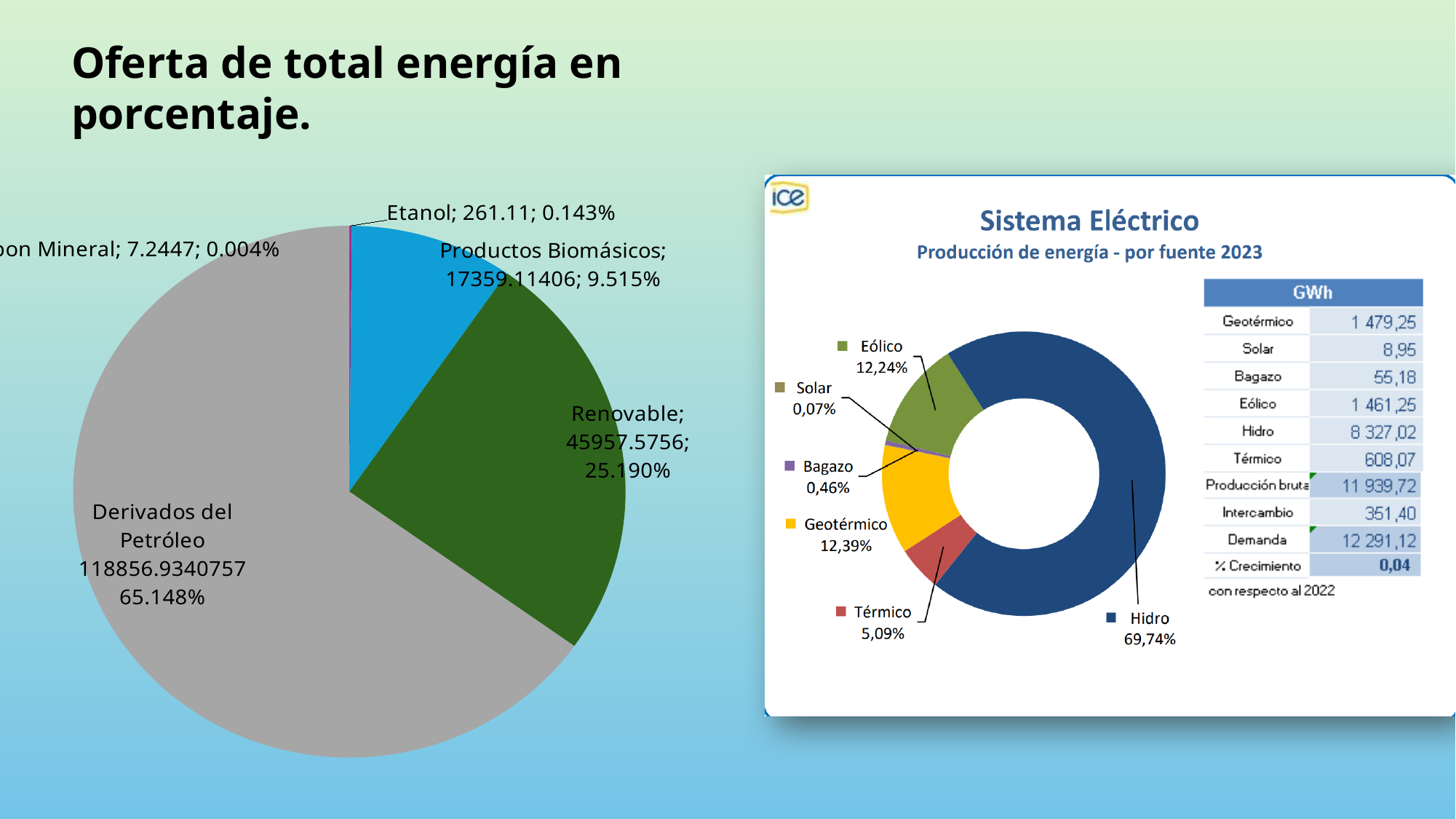
In the left pie chart, which category has the largest slice? Derivados del Petróleo How many energy sources are shown in the Sistema Eléctrico donut chart? 6 In the left pie chart, what is the difference in percentage points between Renovable (25.190%) and Productos Biomásicos (9.515%)? 15.675 In the Sistema Eléctrico table, what is the GWh value for Hidro? 8 327,02 In the left pie chart, what percentage is shown for Productos Biomásicos? 9.515% In the Sistema Eléctrico chart, what percentage is shown for Térmico? 5,09% In the left pie chart, what value is shown for Renovable? 45957.5756 In the left pie chart, which is larger, Renovable or Productos Biomásicos? Renovable In the left pie chart, what percentage share is shown for Derivados del Petróleo? 65.148% In the Sistema Eléctrico chart, which source has the smallest share? Solar In the Sistema Eléctrico chart, what percentage share does Hidro have? 69,74% What kind of chart is the Sistema Eléctrico chart on the right? Donut (pie) chart